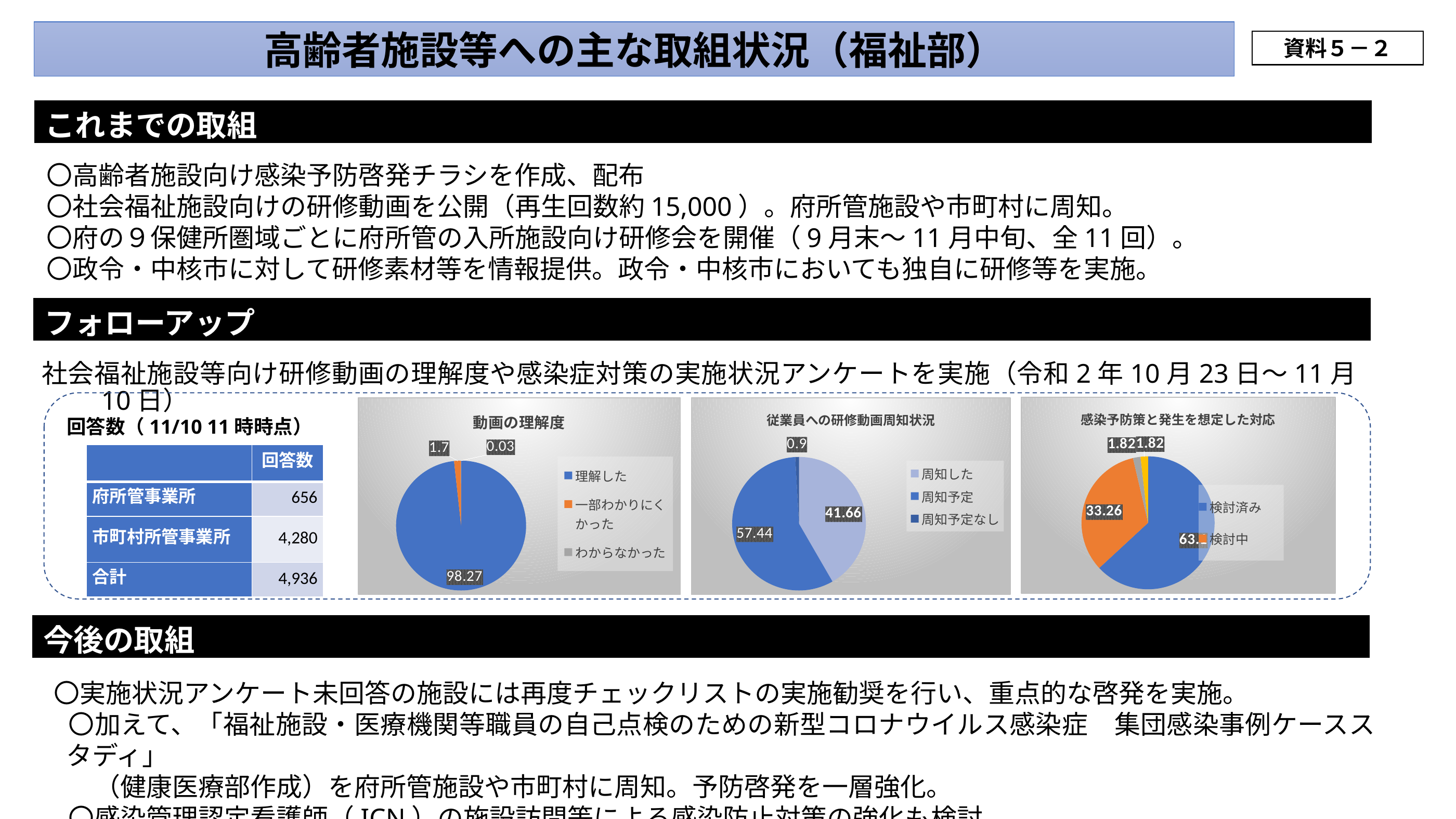
In the pie chart titled 従業員への研修動画周知状況, what is the value for 周知予定? 57.44 In the pie chart titled 従業員への研修動画周知状況, what is the value for 周知予定なし? 0.9 In the pie chart titled 感染予防策と発生を想定した対応, what is the value for 検討中? 33.26 What kind of chart is the chart titled 動画の理解度? pie chart How many entries does the legend of the chart titled 動画の理解度 list? 3 In the pie chart titled 従業員への研修動画周知状況, what is the difference between the values for 周知予定 and 周知した? 15.78 In the pie chart titled 動画の理解度, what is the value for 理解した? 98.27 In the pie chart titled 動画の理解度, what is the value for 一部わかりにくかった? 1.7 In the pie chart titled 従業員への研修動画周知状況, what is the value for 周知した? 41.66 In the pie chart titled 動画の理解度, what is the value for わからなかった? 0.03 In the pie chart titled 動画の理解度, which category has the largest slice? 理解した In the pie chart titled 従業員への研修動画周知状況, which is larger, 周知した or 周知予定? 周知予定